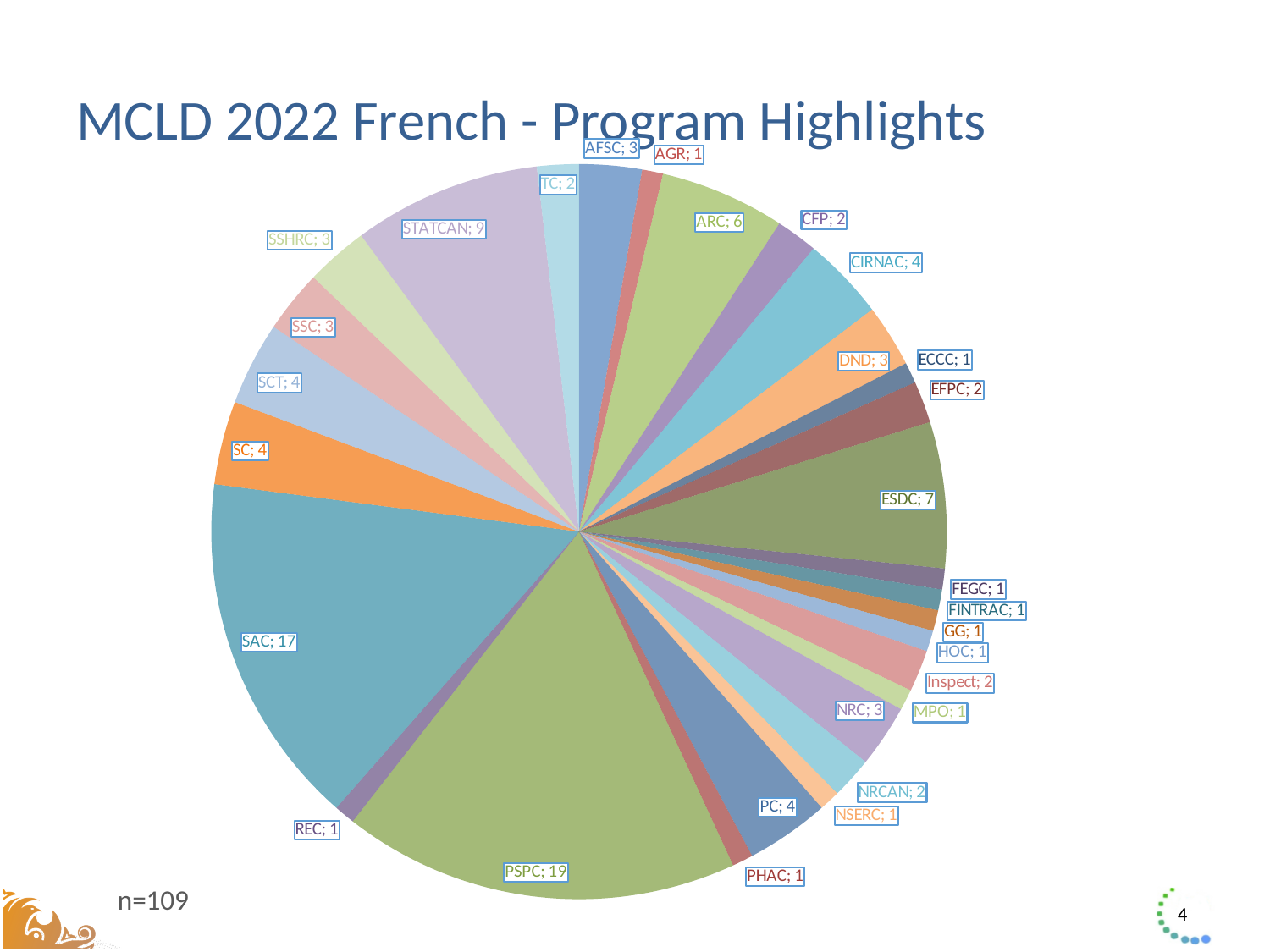
Which category has the largest slice of the pie? PSPC What is the value for ESDC? 7 What total sample size (n) is stated on the slide? n=109 What type of chart is shown on the slide? pie chart What is the value for SAC? 17 What is the value for STATCAN? 9 Which is larger, the value for ARC or the value for DND? ARC What is the value for CIRNAC? 4 What is the title of the slide containing the chart? MCLD 2022 French - Program Highlights What is the value for PSPC? 19 What is the difference between the values for PSPC and SAC? 2 What is the difference between the values for STATCAN and ESDC? 2